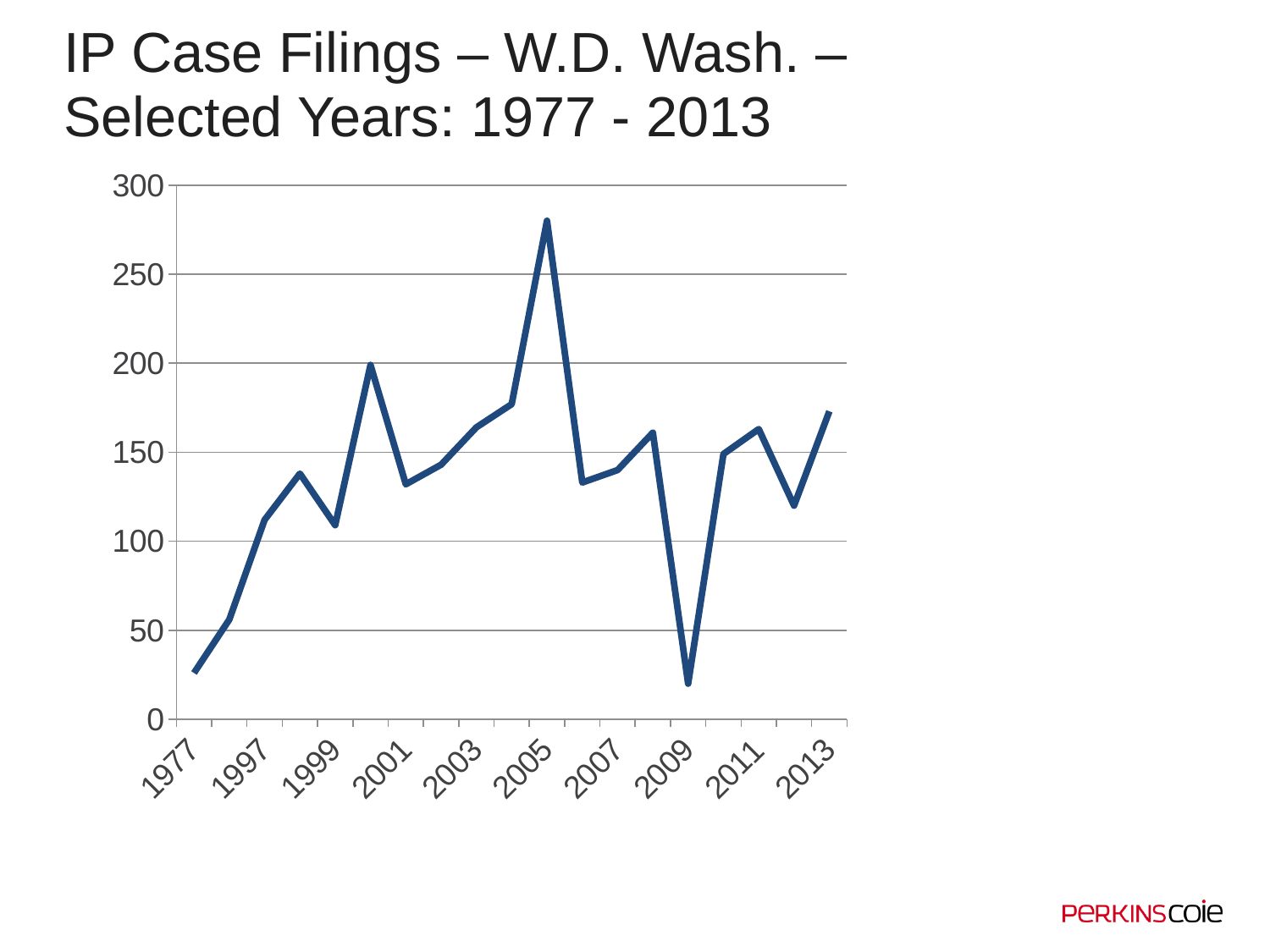
Is the value for 2013 greater or less than 150? greater Is the value for 1977 greater or less than 50? less Do the values rise or fall from 1977 to 1997? rise What kind of chart is shown on the slide? line chart Which year has the lowest number of IP case filings? 2009 Which year has more IP case filings, 2009 or 2011? 2011 Is the value for 2005 greater or less than 250? greater Which year has the highest number of IP case filings? 2005 Which year has more IP case filings, 1977 or 2013? 2013 What is the title of the chart? IP Case Filings – W.D. Wash. – Selected Years: 1977 - 2013